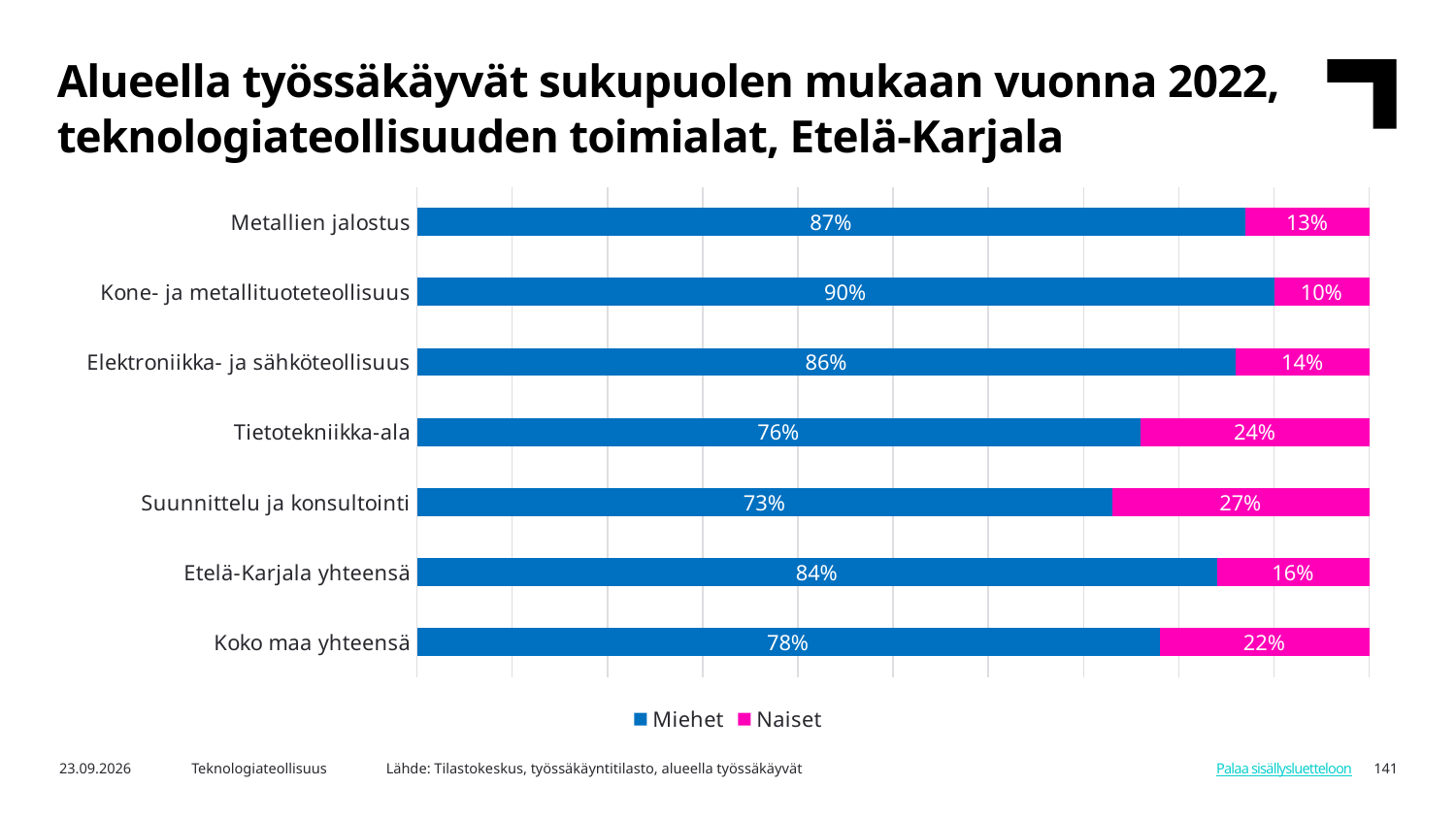
Which category has the lowest Naiset share? Kone- ja metallituoteteollisuus How many series does the legend list? 2 What is the Naiset share for Suunnittelu ja konsultointi? 27% What is the Miehet share for Kone- ja metallituoteteollisuus? 90% What is the Naiset share for Koko maa yhteensä? 22% How many categories are shown on the chart? 7 Which category has the highest Naiset share? Suunnittelu ja konsultointi What is the Miehet share for Etelä-Karjala yhteensä? 84% What kind of chart is shown on the slide? Stacked bar chart Which is larger: the Naiset share for Elektroniikka- ja sähköteollisuus or for Etelä-Karjala yhteensä? Etelä-Karjala yhteensä What is the difference between the Miehet share for Metallien jalostus and for Tietotekniikka-ala? 11 percentage points What is the total of the stacked bar for Tietotekniikka-ala? 100%